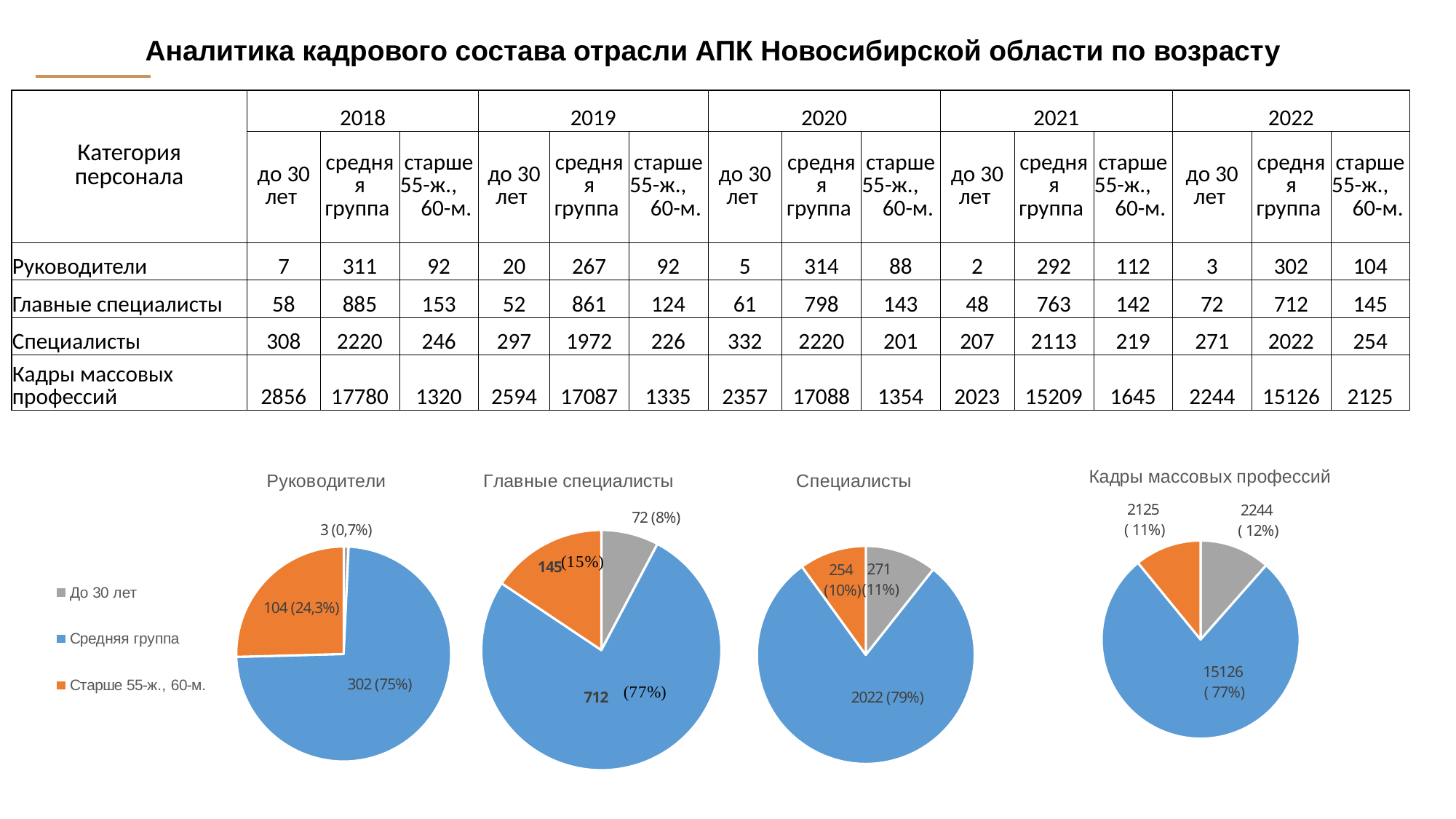
In the pie chart titled "Главные специалисты", what share of the pie does the "Старше 55-ж., 60-м." slice have? 15% In the pie chart titled "Руководители", what value is shown for the "Средняя группа" slice? 302 (75%) How many series does the legend list for the pie charts? 3 In the pie chart titled "Руководители", what share of the pie does the "Старше 55-ж., 60-м." slice have? 24,3% In the pie chart titled "Кадры массовых профессий", what value is shown for the "Средняя группа" slice? 15126 In the pie chart titled "Кадры массовых профессий", which is larger: the "До 30 лет" slice or the "Старше 55-ж., 60-м." slice? До 30 лет In the pie chart titled "Главные специалисты", what value is shown for the "До 30 лет" slice? 72 (8%) In the pie chart titled "Руководители", which slice is the smallest? До 30 лет In the pie chart titled "Специалисты", what share of the pie does the "Средняя группа" slice have? 79% In the pie chart titled "Кадры массовых профессий", what is the difference between the "До 30 лет" value and the "Старше 55-ж., 60-м." value? 119 In the pie chart titled "Специалисты", which slice is the largest? Средняя группа What type of chart is used for "Руководители"? Pie chart